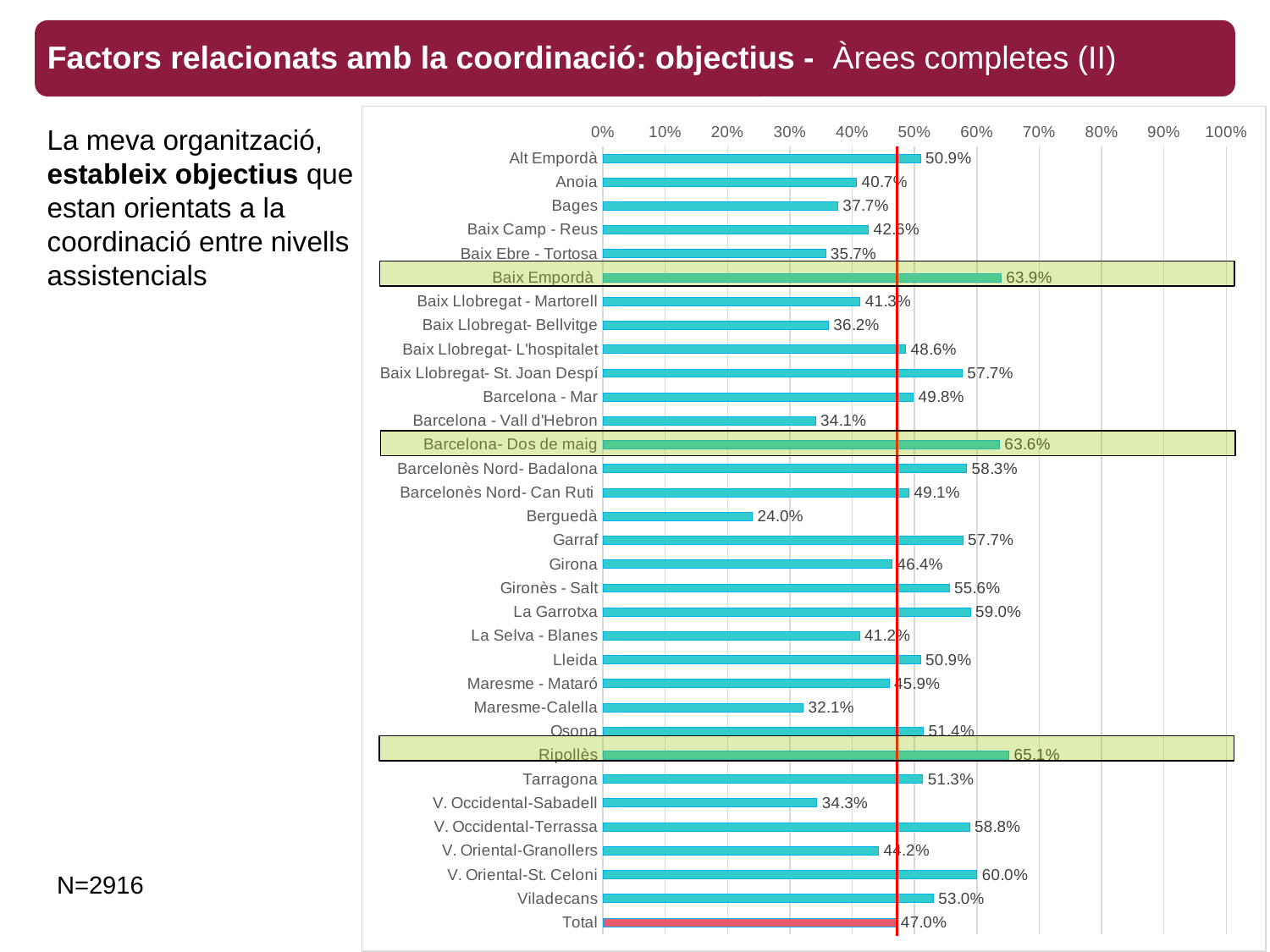
What is the value for Ripollès? 65.1% What is the value for Berguedà? 24.0% What is the value for the Total bar? 47.0% What is the value for Baix Empordà? 63.9% What is the difference between the values for Ripollès and Berguedà? 41.1% Which category has the highest value? Ripollès Which category has the lowest value? Berguedà How many bars are plotted in the chart, including Total? 33 Is the value for V. Oriental-St. Celoni greater or less than 50%? greater What type of chart is shown on the slide? Bar chart What colour is the Total bar? Red Which is larger, the value for Viladecans or the value for Tarragona? Viladecans